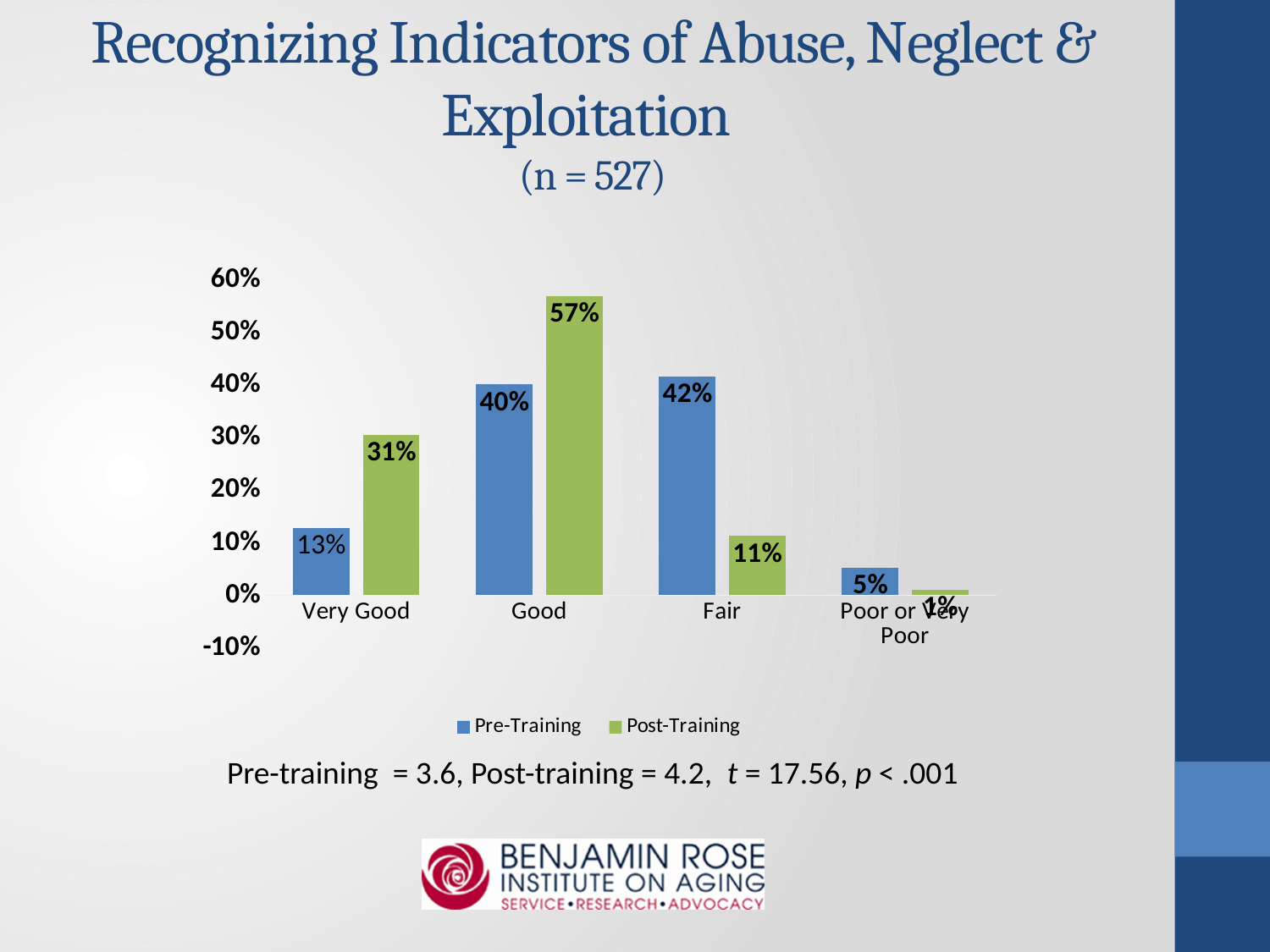
Which category has the lowest Pre-Training value? Poor or Very Poor What is the difference between the Post-Training and Pre-Training values for Very Good? 18% What is the Post-Training value for Good? 57% Which is larger for Fair: the Pre-Training value or the Post-Training value? Pre-Training What is the Pre-Training value for Fair? 42% How many series does the legend list? 2 What kind of chart is shown on the slide? Bar chart Which category has the highest Post-Training value? Good How many categories are shown on the x axis? 4 What is the Post-Training value for Poor or Very Poor? 1% What is the sample size (n) given in the chart title? 527 What is the Pre-Training value for Very Good? 13%